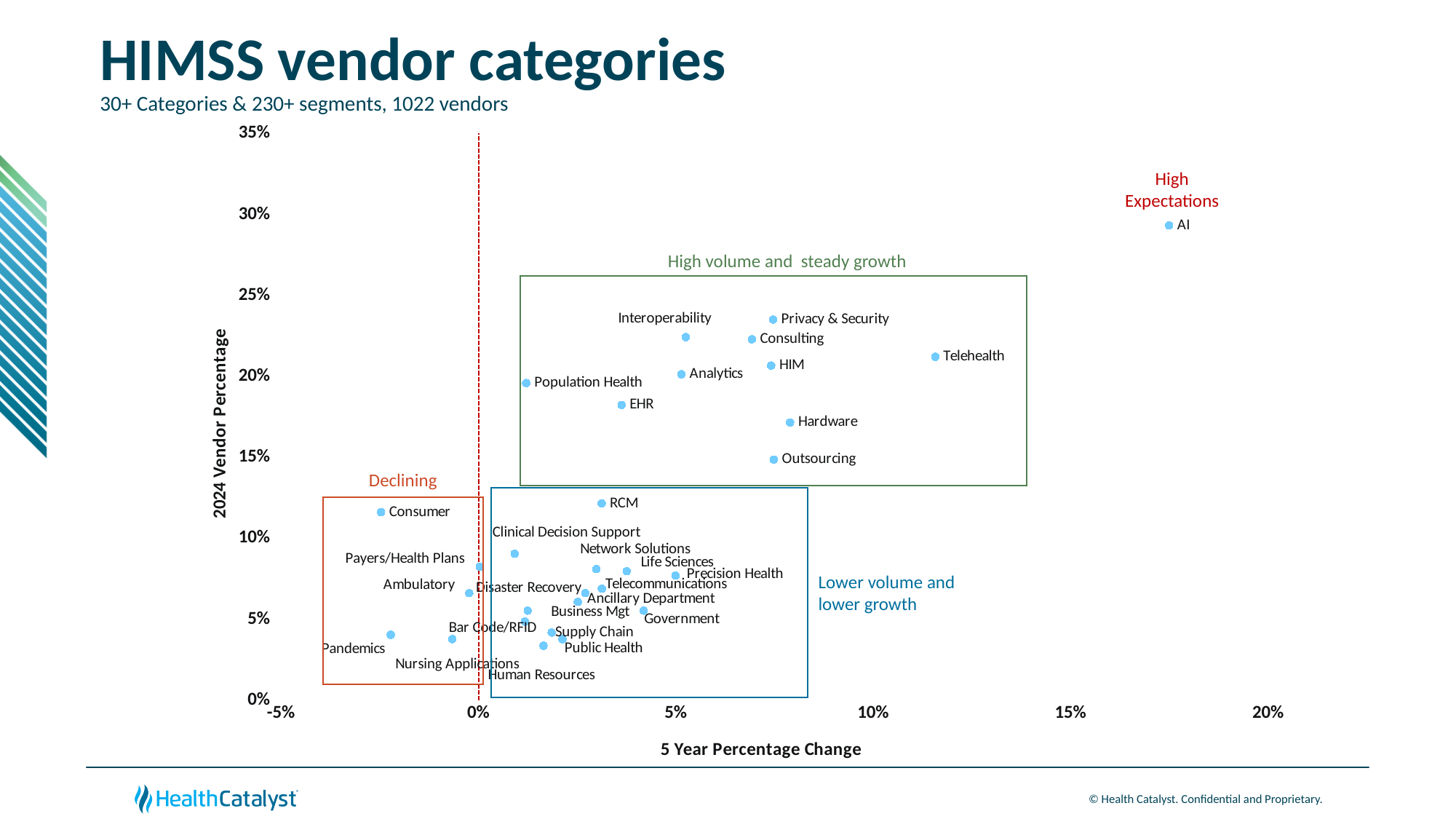
Which has a larger 5 Year Percentage Change, Telehealth or Population Health? Telehealth Which vendor category has the highest 2024 Vendor Percentage? AI Which group label is shown above the green box on the chart? High volume and steady growth What kind of chart is shown on the slide? scatter chart Is the 2024 Vendor Percentage for Human Resources greater or less than 5%? less Is the 2024 Vendor Percentage for Consumer greater or less than 10%? greater Which has a larger 2024 Vendor Percentage, Privacy & Security or Outsourcing? Privacy & Security Is the 5 Year Percentage Change for Telehealth greater or less than 10%? greater What is the title of the vertical axis? 2024 Vendor Percentage Which vendor category has the highest 5 Year Percentage Change? AI